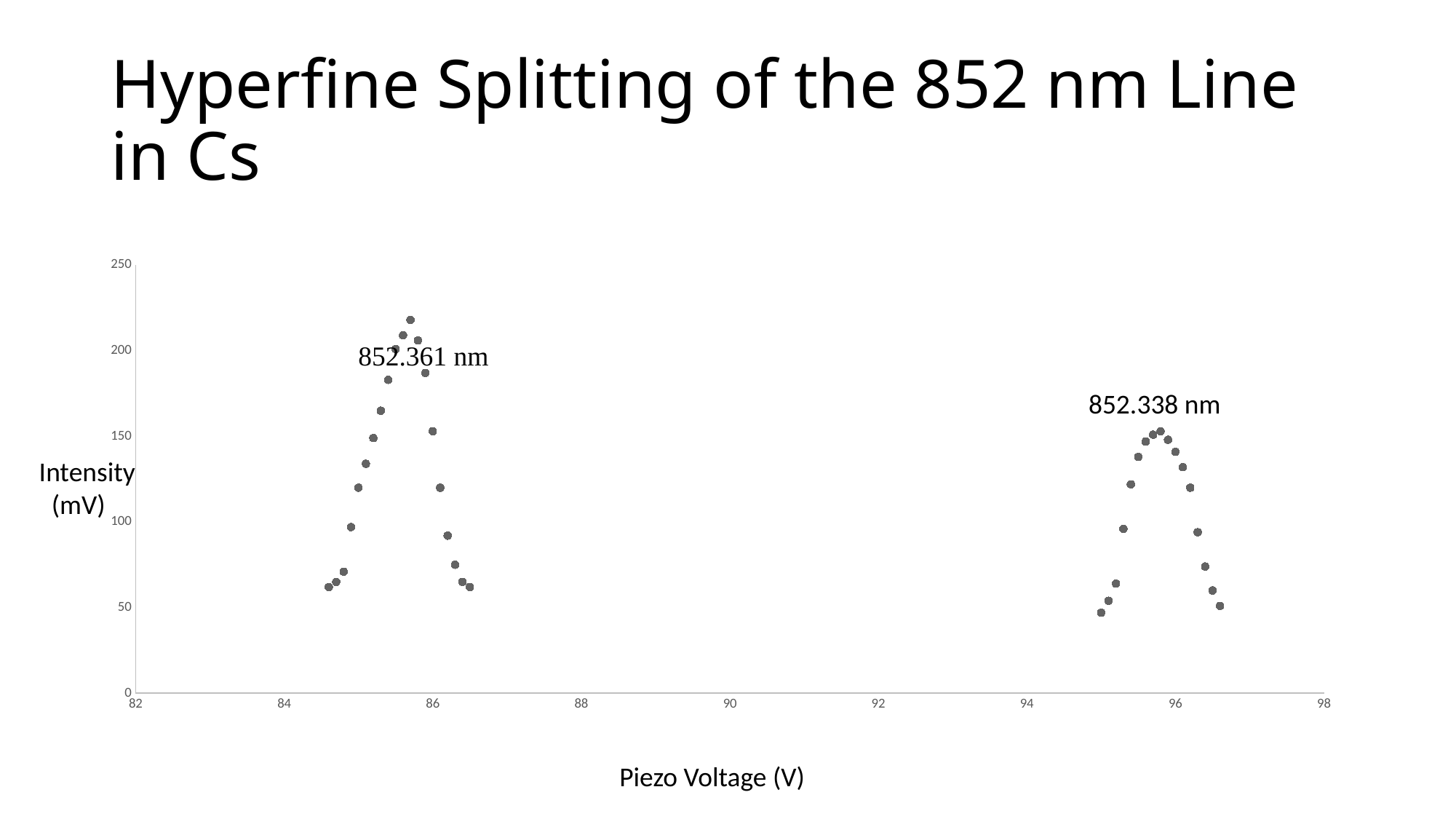
Is the maximum intensity of the 852.338 nm peak greater or less than 200? less What is the label of the x axis? Piezo Voltage (V) Which labelled peak reaches the higher intensity, 852.361 nm or 852.338 nm? 852.361 nm Is the piezo voltage at the 852.361 nm peak greater or less than 88? less How many peaks (wavelength lines) are labelled on the chart? 2 Is the piezo voltage at the 852.338 nm peak greater or less than 94? greater Which labelled peak occurs at the higher piezo voltage? 852.338 nm What kind of chart is shown on the slide? Scatter chart What is the title of the slide's chart? Hyperfine Splitting of the 852 nm Line in Cs Does the intensity rise or fall as piezo voltage increases from 84.6 V to about 85.7 V within the 852.361 nm peak? rise